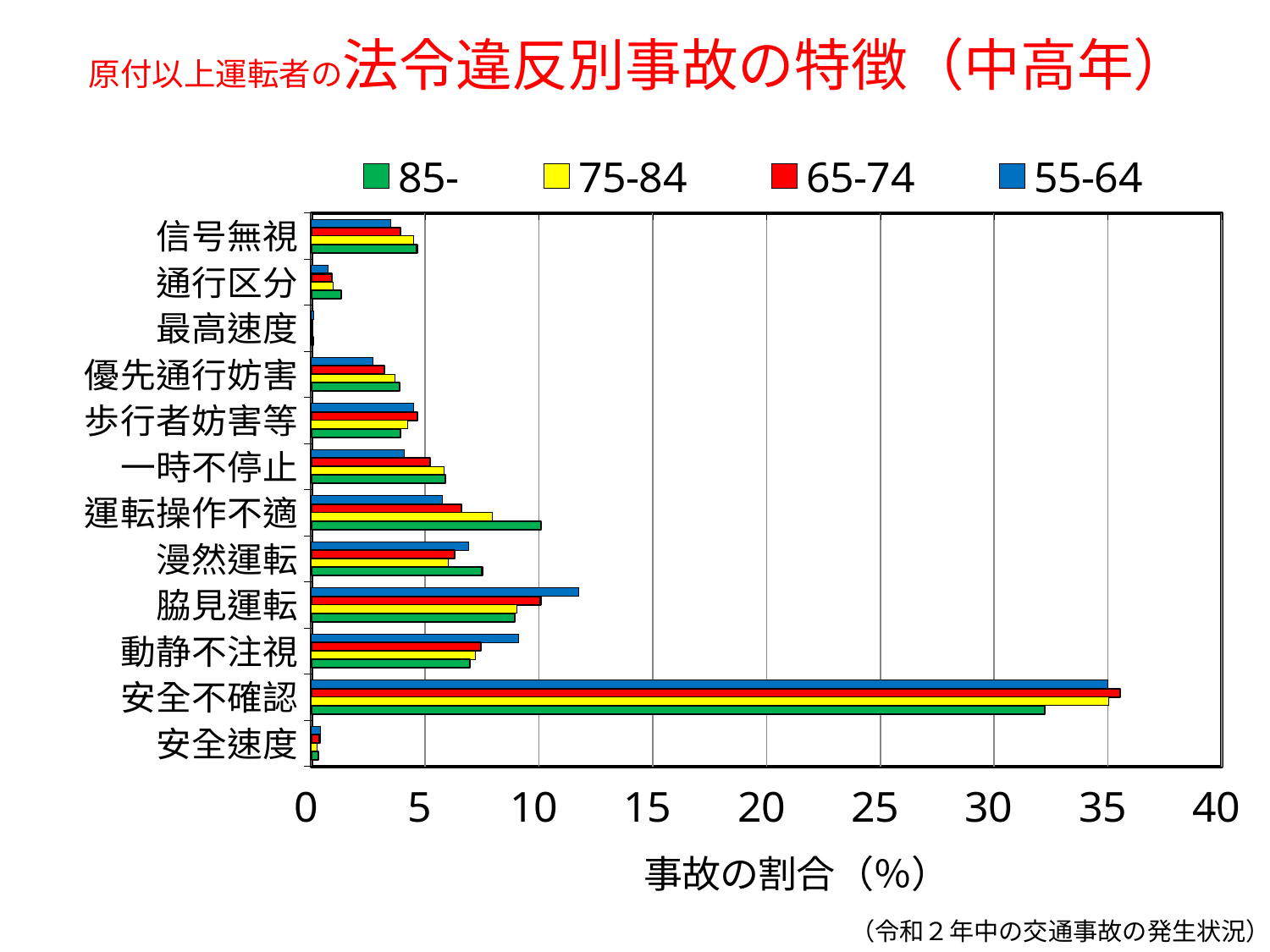
What is the x-axis title of the chart? 事故の割合（%） How many series does the legend list? 4 Which category has the highest values across all age groups? 安全不確認 Is the value for 一時不停止 in the 85- series greater or less than 5? greater Is the value for 安全不確認 in the 55-64 series greater or less than 30? greater Is the value for 通行区分 in the 85- series greater or less than 5? less For 安全不確認, which series has the larger value: 65-74 or 85-? 65-74 What kind of chart is shown on the slide? bar chart For 運転操作不適, which series has the larger value: 85- or 55-64? 85- Which category has the lowest values across all age groups? 最高速度 How many violation categories are plotted on the y axis? 12